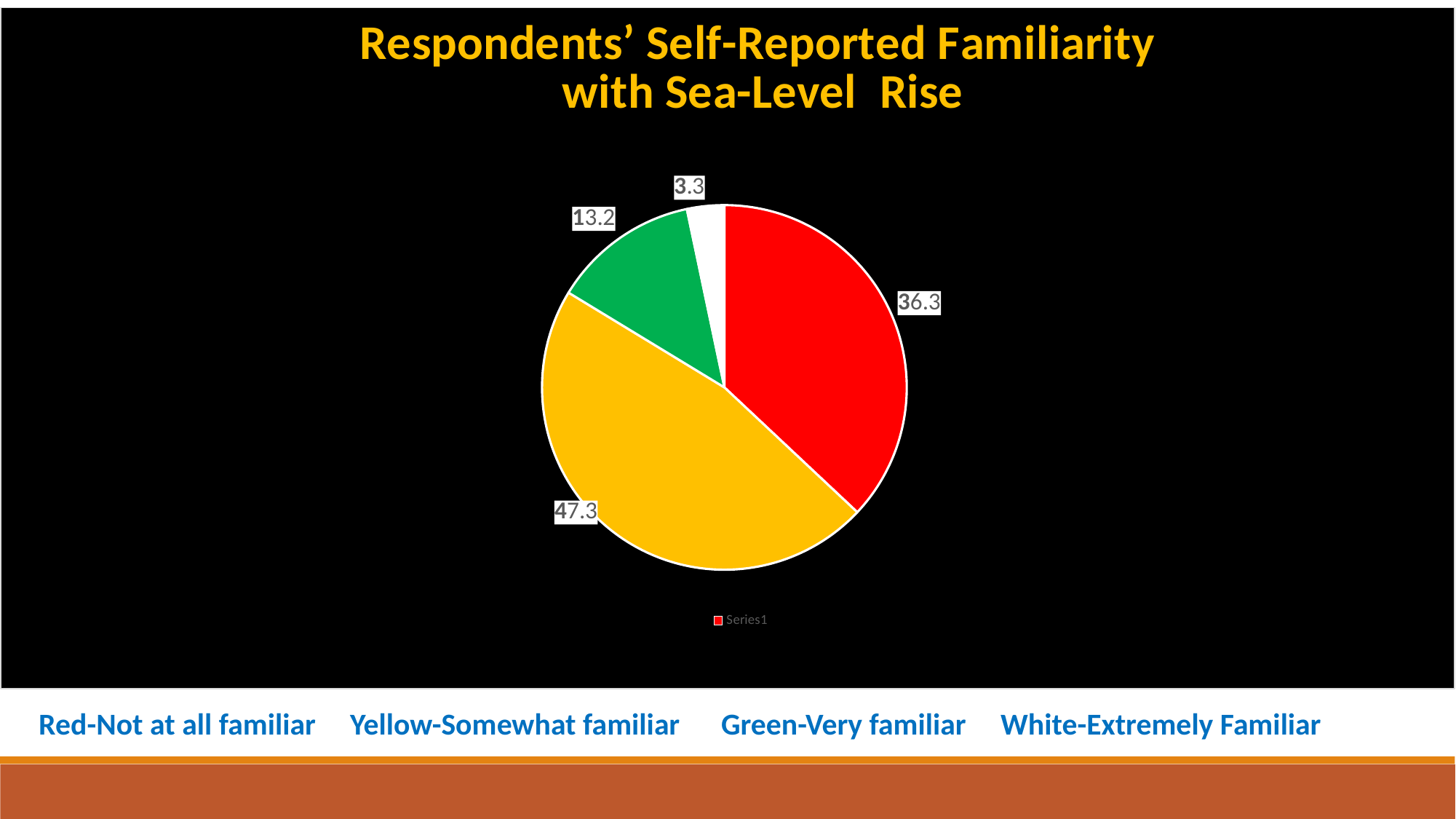
What colour represents 'Very familiar' in the chart? Green Which familiarity category has the largest slice? Somewhat familiar Which is larger, the 'Very familiar' slice or the 'Extremely Familiar' slice? Very familiar Which familiarity category has the smallest slice? Extremely Familiar What is the value for the 'Very familiar' (green) slice? 13.2 What is the value for the 'Somewhat familiar' (yellow) slice? 47.3 What is the title of the chart? Respondents' Self-Reported Familiarity with Sea-Level Rise What is the value for the 'Not at all familiar' (red) slice? 36.3 What is the difference between the 'Somewhat familiar' and 'Not at all familiar' values? 11 How many slices does the pie chart have? 4 What is the value for the 'Extremely Familiar' (white) slice? 3.3 What kind of chart is shown on the slide? Pie chart